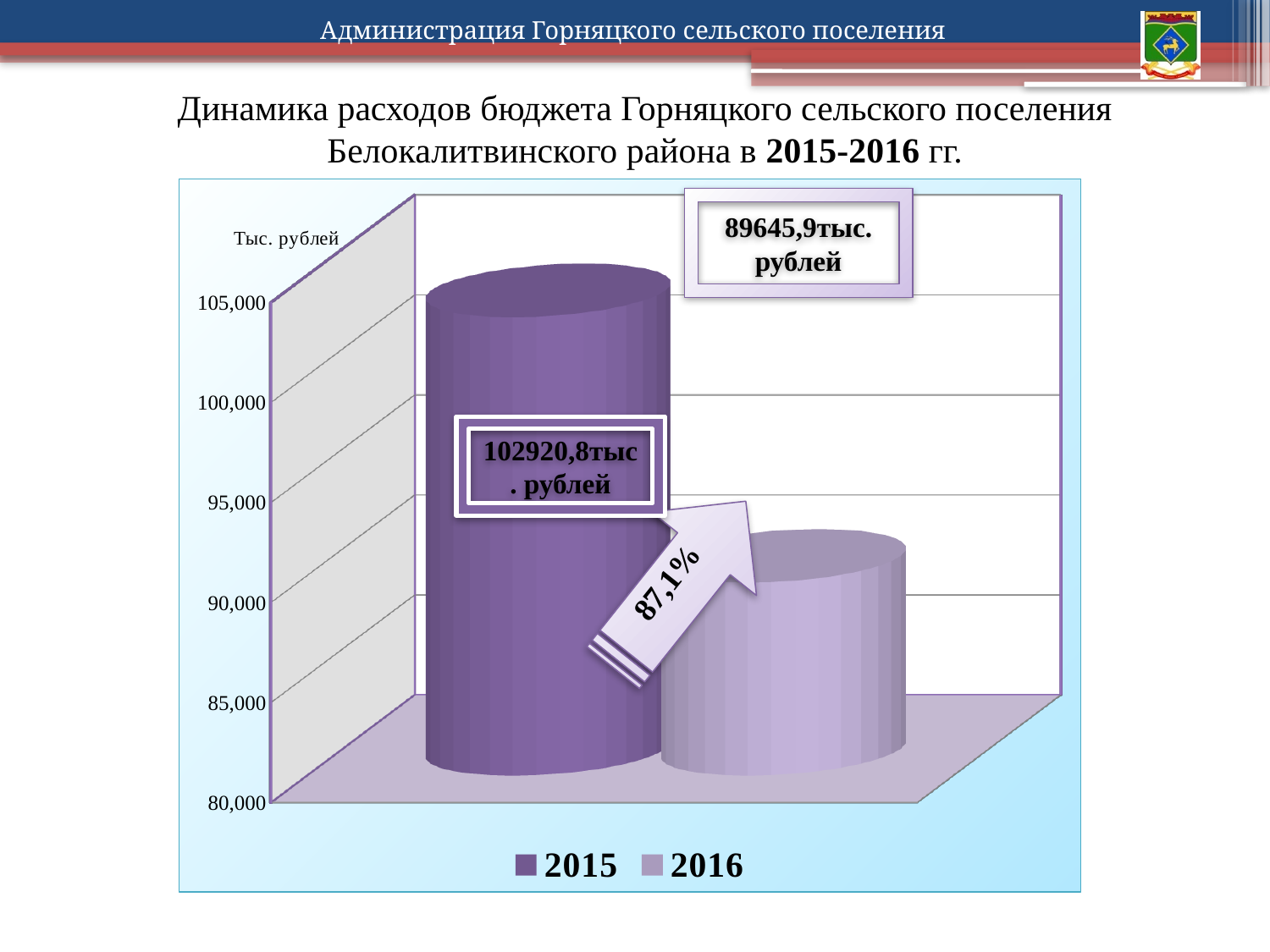
Which year has the lower budget expenditure value? 2016 What is the difference between the 2015 value and the 2016 value? 13274,9 тыс. рублей Is the value for 2016 greater or less than 95,000? less What is the value shown for 2016? 89645,9 тыс. рублей Do the values rise or fall from 2015 to 2016? fall Is the value for 2015 greater or less than 100,000? greater What is the value shown for 2015? 102920,8 тыс. рублей How many series does the legend list? 2 Is the value for 2015 larger or smaller than the value for 2016? larger What percentage is written on the arrow between the two bars? 87,1% What kind of chart is shown on the slide? bar chart Which year has the higher budget expenditure value? 2015